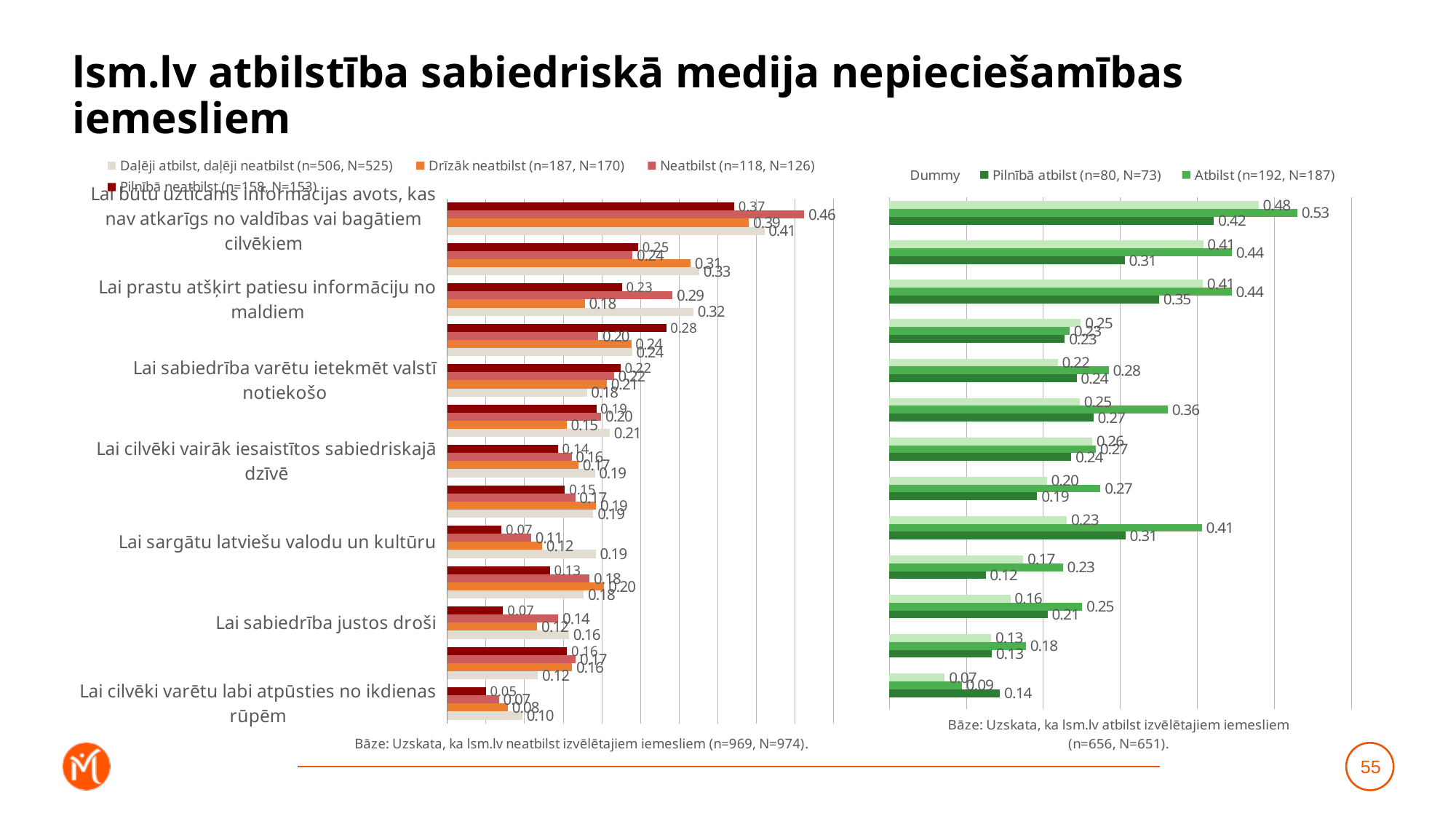
How many series does the legend of the right chart list? 3 What is the lowest value labelled in the right chart? 0.07 What is the highest value labelled in the right chart? 0.53 In the left chart, what is the 'Pilnībā neatbilst' value for 'Lai būtu uzticams informācijas avots, kas nav atkarīgs no valdības vai bagātiem cilvēkiem'? 0.37 In the left chart, what is the 'Daļēji atbilst, daļēji neatbilst' value for 'Lai cilvēki varētu labi atpūsties no ikdienas rūpēm'? 0.10 How many series does the legend of the left chart list? 4 What kind of chart is shown on the left side of the slide? Bar chart In the left chart, what is the difference between the 'Neatbilst' and 'Pilnībā neatbilst' values for 'Lai būtu uzticams informācijas avots, kas nav atkarīgs no valdības vai bagātiem cilvēkiem'? 0.09 In the left chart, what is the 'Neatbilst' value for 'Lai būtu uzticams informācijas avots, kas nav atkarīgs no valdības vai bagātiem cilvēkiem'? 0.46 In the left chart, what is the 'Pilnībā neatbilst' value for 'Lai cilvēki varētu labi atpūsties no ikdienas rūpēm'? 0.05 According to the note under the left chart, what is the base (n) for the left chart? n=969, N=974 In the left chart, for 'Lai būtu uzticams informācijas avots, kas nav atkarīgs no valdības vai bagātiem cilvēkiem', which is larger: the 'Neatbilst' value or the 'Pilnībā neatbilst' value? Neatbilst